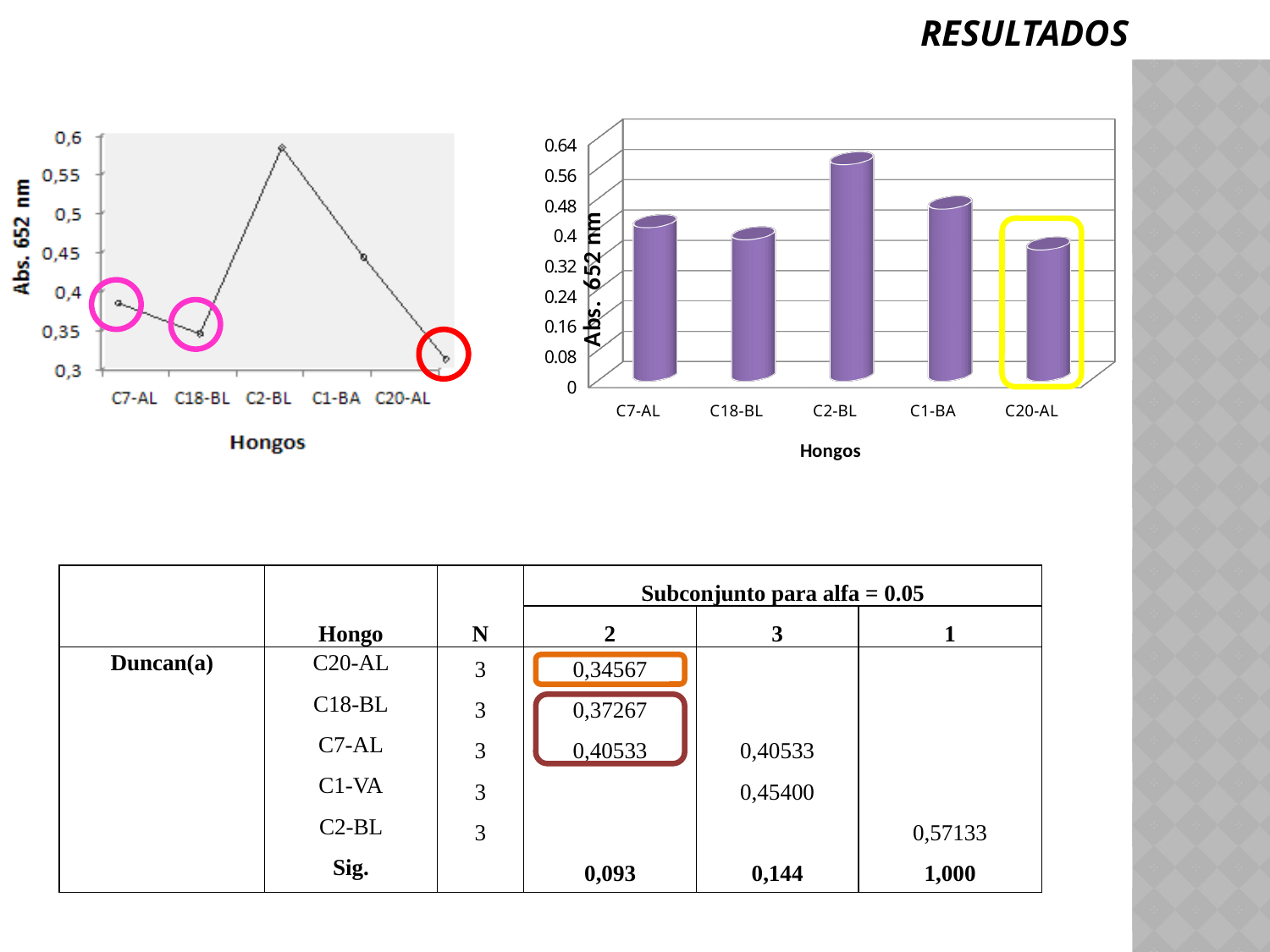
In the line chart on the left, which category has the lowest value? C20-AL In the line chart on the left, is the value for C20-AL greater or less than 0,35? less What kind of chart is the chart on the left of the slide? line chart In the line chart on the left, do the values rise or fall from C2-BL to C20-AL? fall In the bar chart on the right, which category has the highest value? C2-BL In the line chart on the left, is the value for C2-BL greater or less than 0,55? greater What is the x-axis title of the bar chart on the right? Hongos In the bar chart on the right, is the value for C20-AL greater or less than 0.4? less What kind of chart is the chart on the right of the slide? bar chart How many categories are shown on the x axis of the bar chart on the right? 5 In the bar chart on the right, which is larger, the value for C1-BA or the value for C7-AL? C1-BA